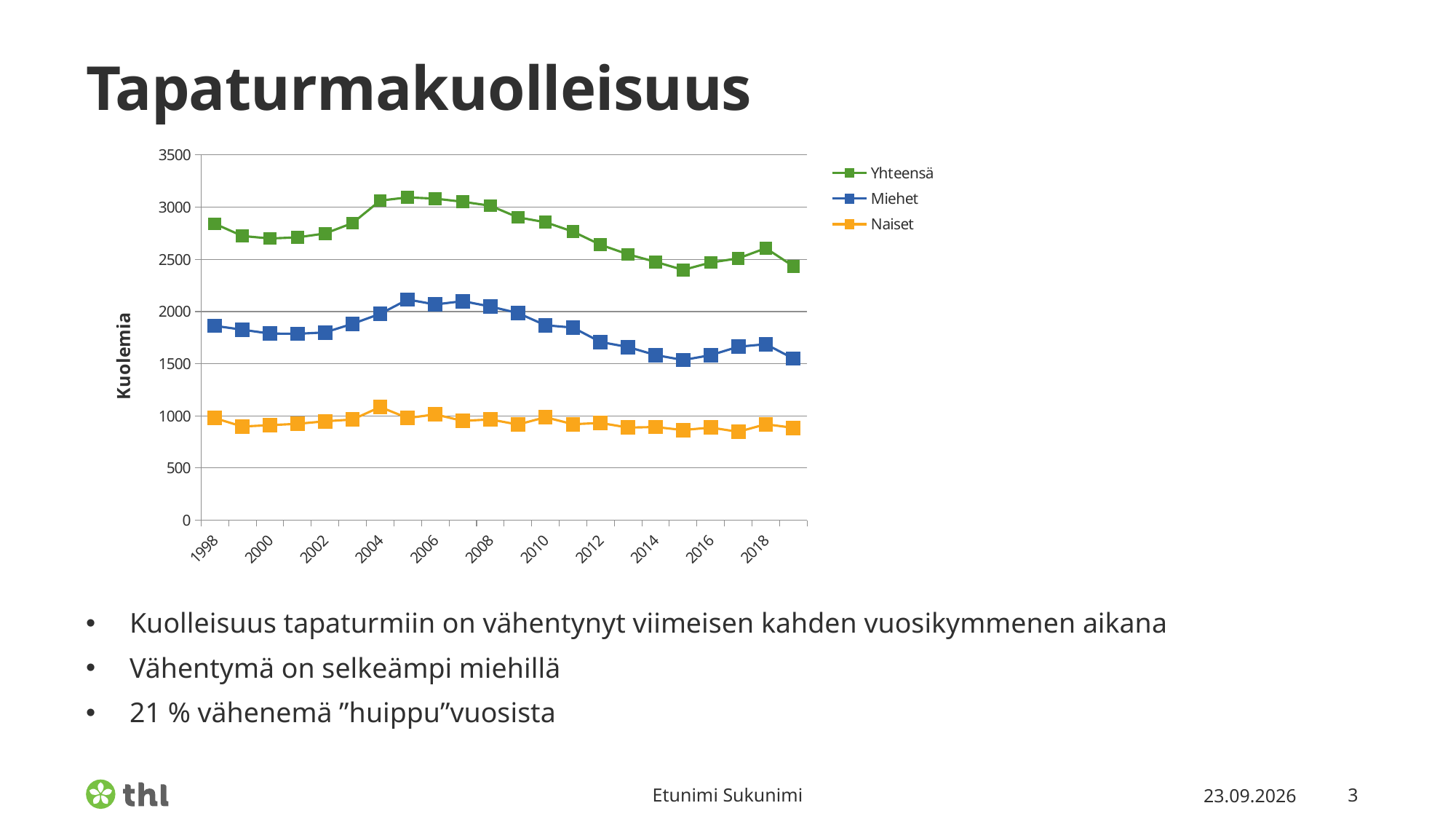
Is the value for Yhteensä in 2015 greater or less than 2500? less Is the value for Miehet in 1998 greater or less than 2000? less How many series does the legend list? 3 What kind of chart is shown on the slide? line chart Is the value for Yhteensä in 2005 greater or less than 3000? greater Which series is plotted in green? Yhteensä Does the Yhteensä series rise or fall between 2005 and 2015? fall What is the title of the vertical axis? Kuolemia Which is larger for Yhteensä: the value in 2005 or the value in 2019? 2005 In which year is the Naiset series at its highest? 2004